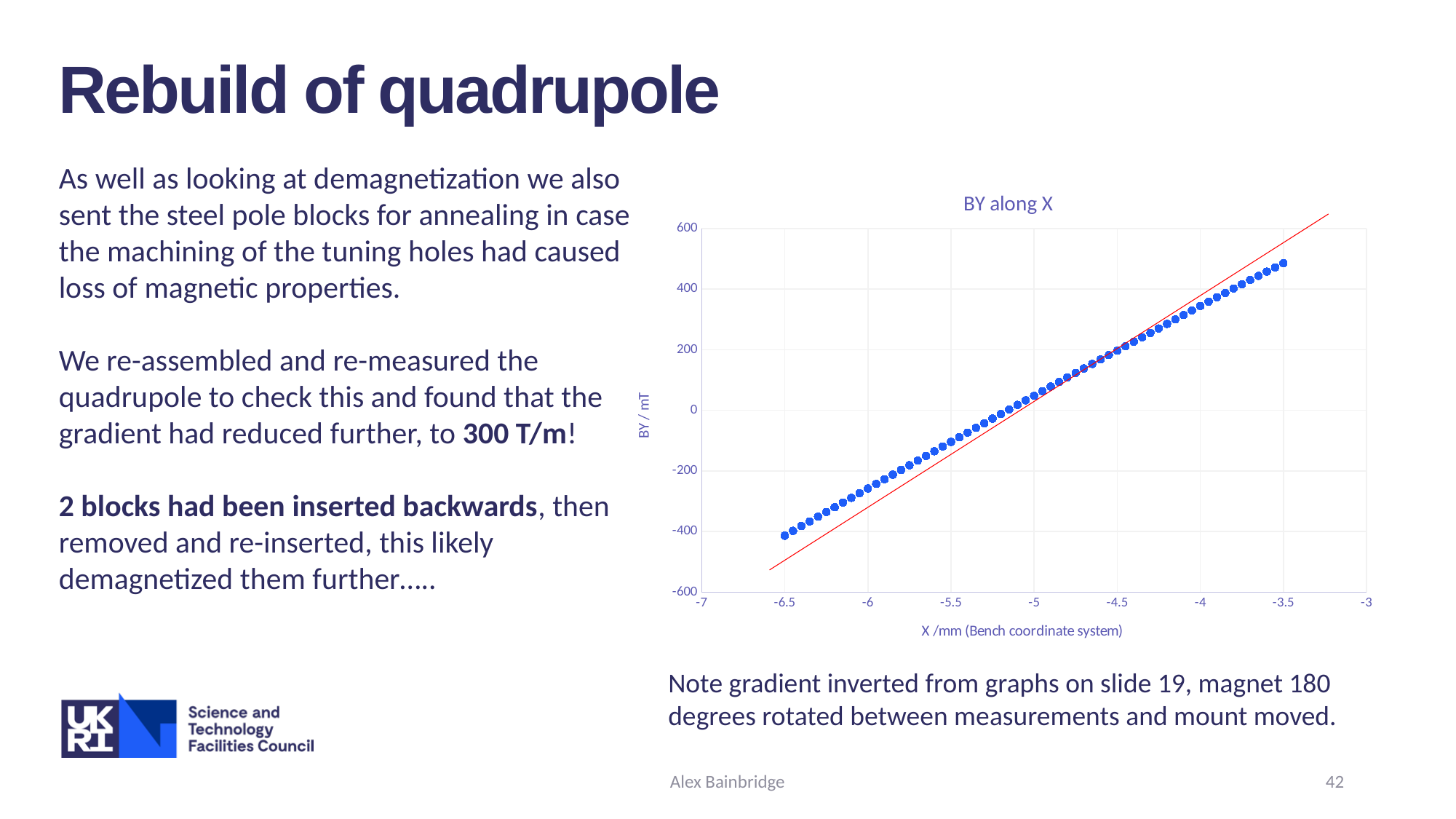
Is the BY value at X = -4.5 greater or less than 0? greater What is the label of the y axis of the chart? BY / mT Do the plotted BY values rise or fall as X increases from -6.5 to -3.5? rise Which X position has the higher BY value, X = -3.5 or X = -6.5? X = -3.5 Is the BY value at X = -4 greater or less than 200? greater What is the title of the chart? BY along X Is the BY value at X = -6.5 greater or less than -200? less What kind of chart is shown on the slide? scatter chart At which end of the plotted X range is BY lowest, X = -6.5 or X = -3.5? X = -6.5